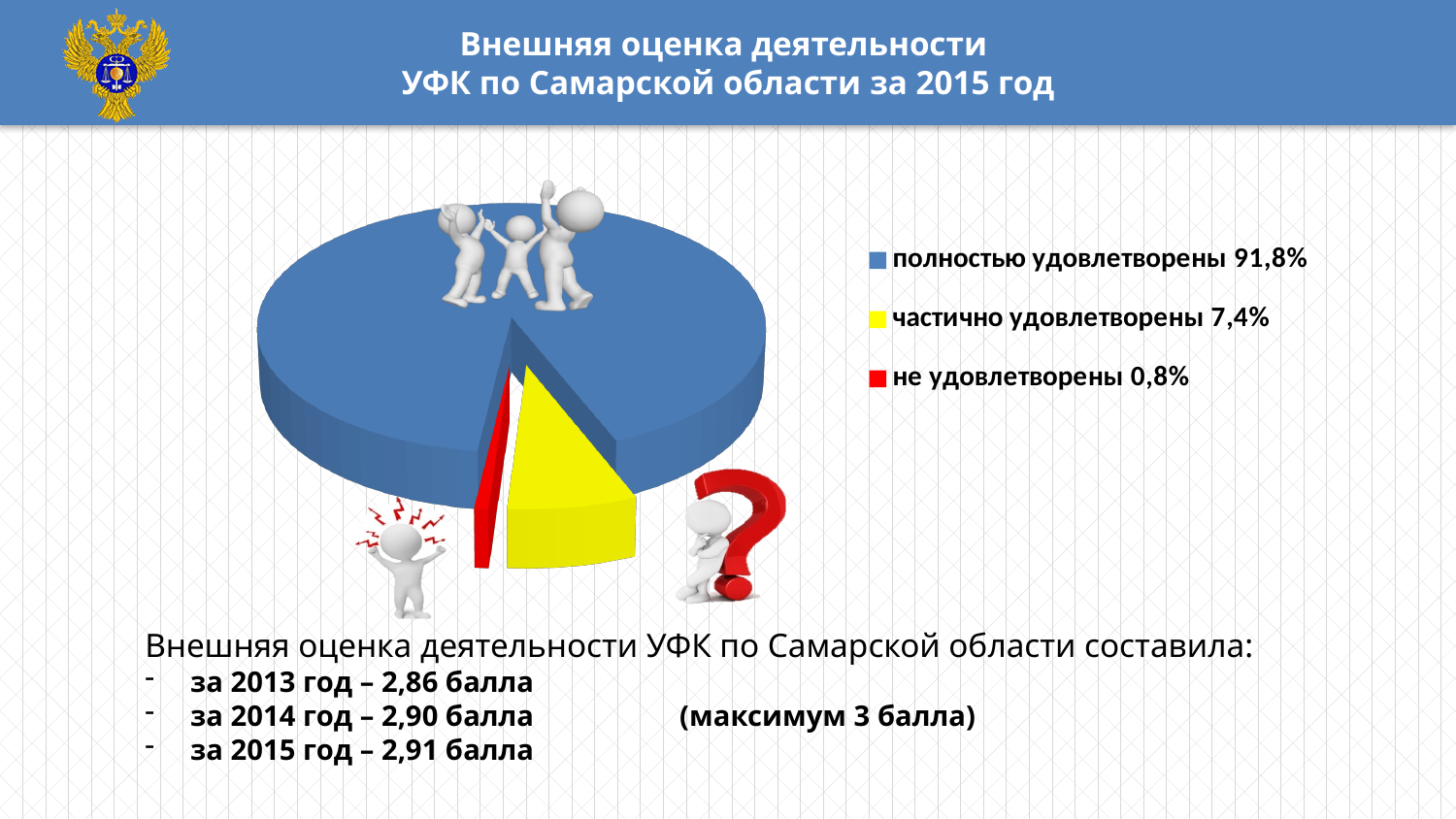
What is the difference between the shares of "полностью удовлетворены" and "частично удовлетворены"? 84,4% What is the value for "не удовлетворены" in the pie chart? 0,8% What share of the pie is "частично удовлетворены"? 7,4% How many slices does the pie chart have? 3 What is the difference between the shares of "частично удовлетворены" and "не удовлетворены"? 6,6% What kind of chart is shown on the slide? pie chart Which category has the largest slice in the pie chart? полностью удовлетворены What colour is the slice for "не удовлетворены" in the pie chart? red How many entries does the legend of the pie chart list? 3 What share of the pie is "полностью удовлетворены"? 91,8% Which category has the smallest slice in the pie chart? не удовлетворены Which is larger in the pie chart: "частично удовлетворены" or "не удовлетворены"? частично удовлетворены